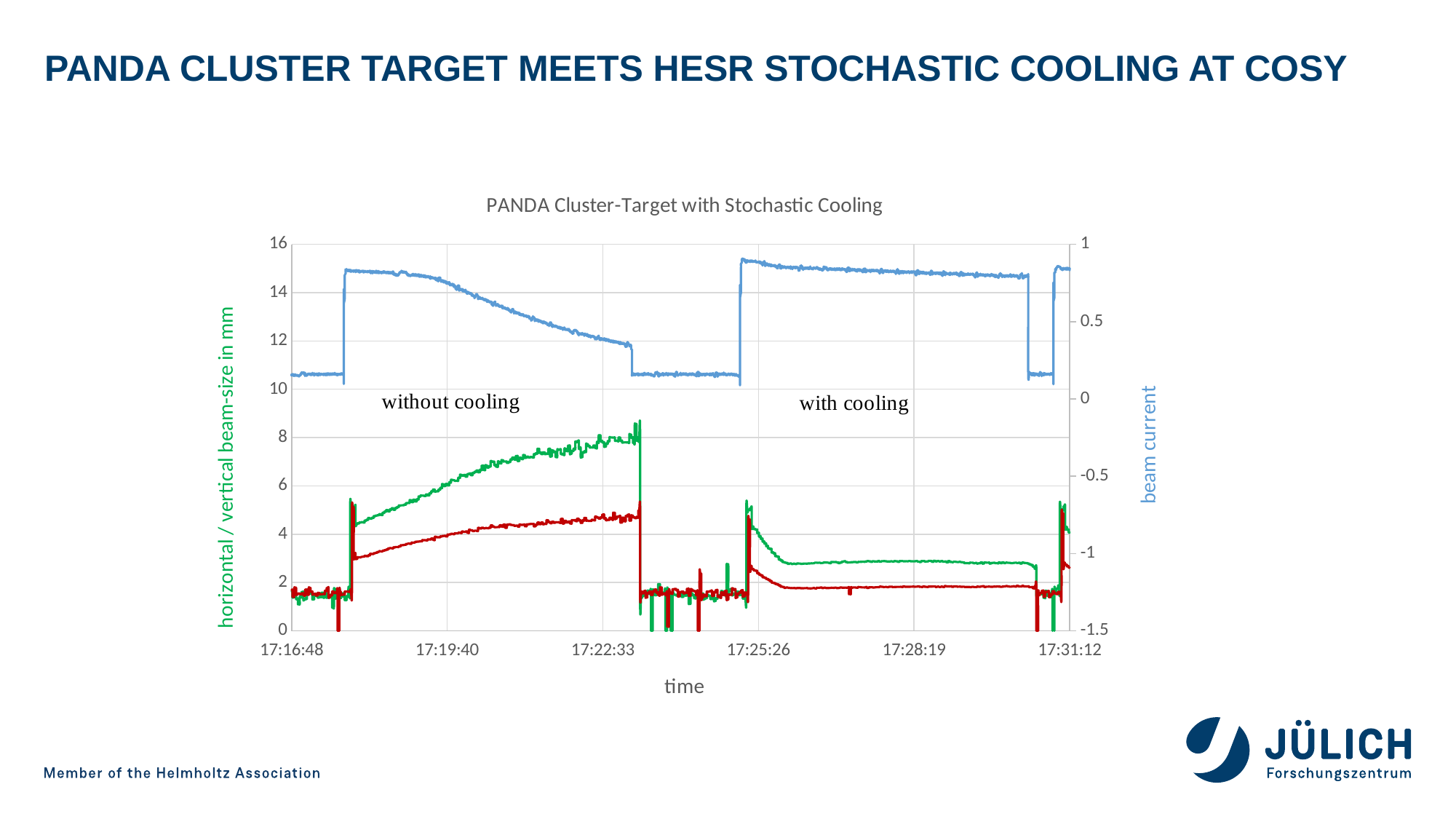
Is the value of the green line at 17:28:19 greater or less than 4 mm? less Does the green line rise or fall between 17:19:40 and 17:22:33? rises How many time labels are shown on the x axis? 6 What is the title of the chart? PANDA Cluster-Target with Stochastic Cooling What kind of chart is shown on the slide? line chart Is the green line higher at 17:22:33 or at 17:28:19? 17:22:33 Is the value of the green line at 17:22:33 greater or less than 6 mm? greater What is the label of the left vertical axis? horizontal / vertical beam-size in mm Does the blue beam current line rise or fall between 17:19:40 and 17:22:33? falls Is the value of the red line at 17:22:33 greater or less than 6 mm? less At 17:28:19, which line is higher on the left axis, the green line or the red line? green line